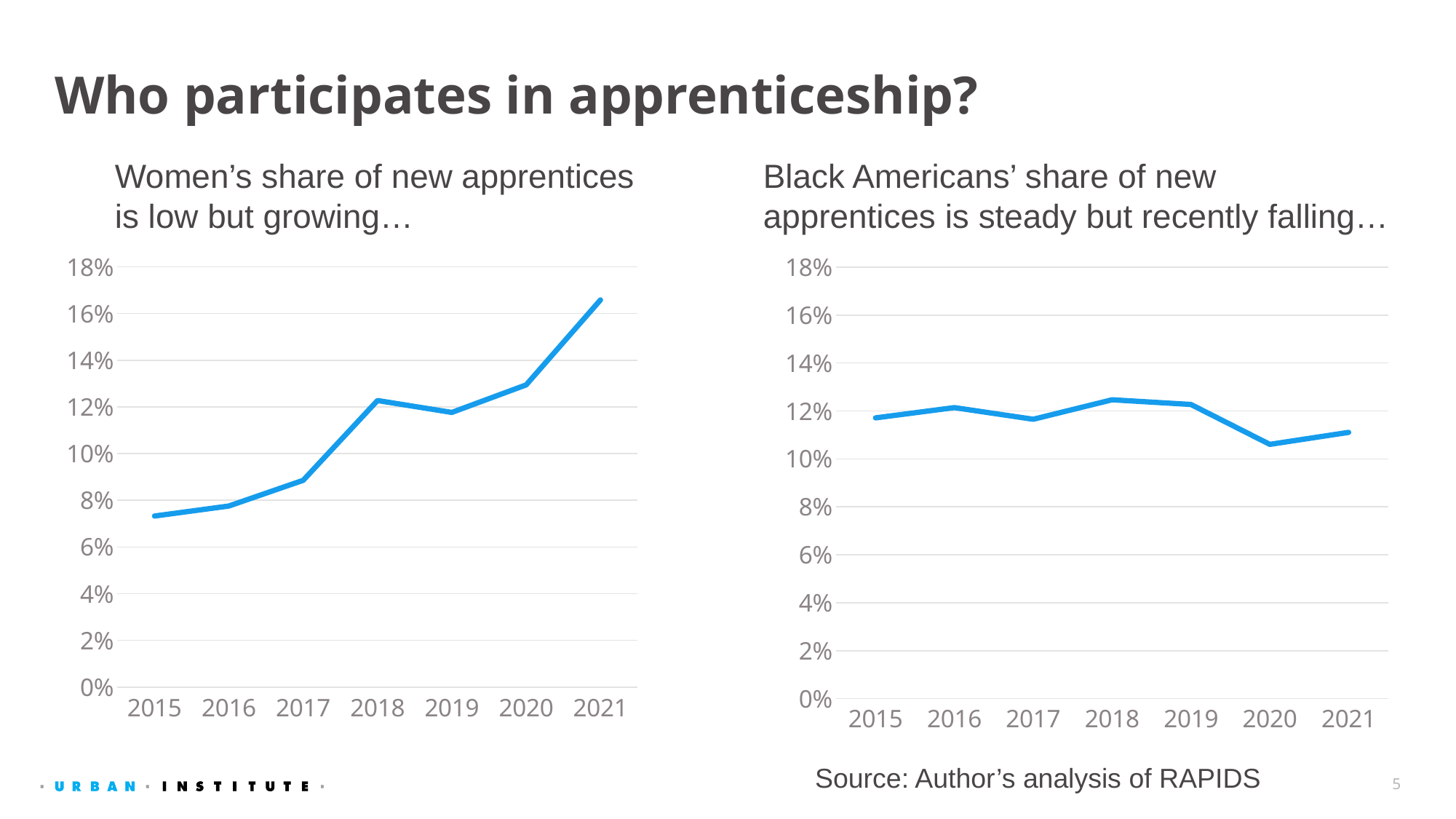
On the right chart, 'Black Americans' share of new apprentices is steady but recently falling…', is the value for 2021 greater or less than 12%? less Which is larger: the 2021 value on the left chart (Women's share) or the 2021 value on the right chart (Black Americans' share)? the left chart (Women's share) On the right chart, 'Black Americans' share of new apprentices is steady but recently falling…', is the value for 2020 greater or less than 10%? greater On the left chart, 'Women's share of new apprentices is low but growing…', which year has the lowest value? 2015 How many years are plotted on the left chart, 'Women's share of new apprentices is low but growing…'? 7 On the left chart, 'Women's share of new apprentices is low but growing…', is the value for 2021 greater or less than 16%? greater On the right chart, 'Black Americans' share of new apprentices is steady but recently falling…', which year has the lowest value? 2020 What is the source cited at the bottom of the slide? Author's analysis of RAPIDS On the left chart, 'Women's share of new apprentices is low but growing…', which year has the highest value? 2021 What kind of chart is the left chart, 'Women's share of new apprentices is low but growing…'? line chart On the left chart, 'Women's share of new apprentices is low but growing…', do the values generally rise or fall from 2015 to 2021? rise